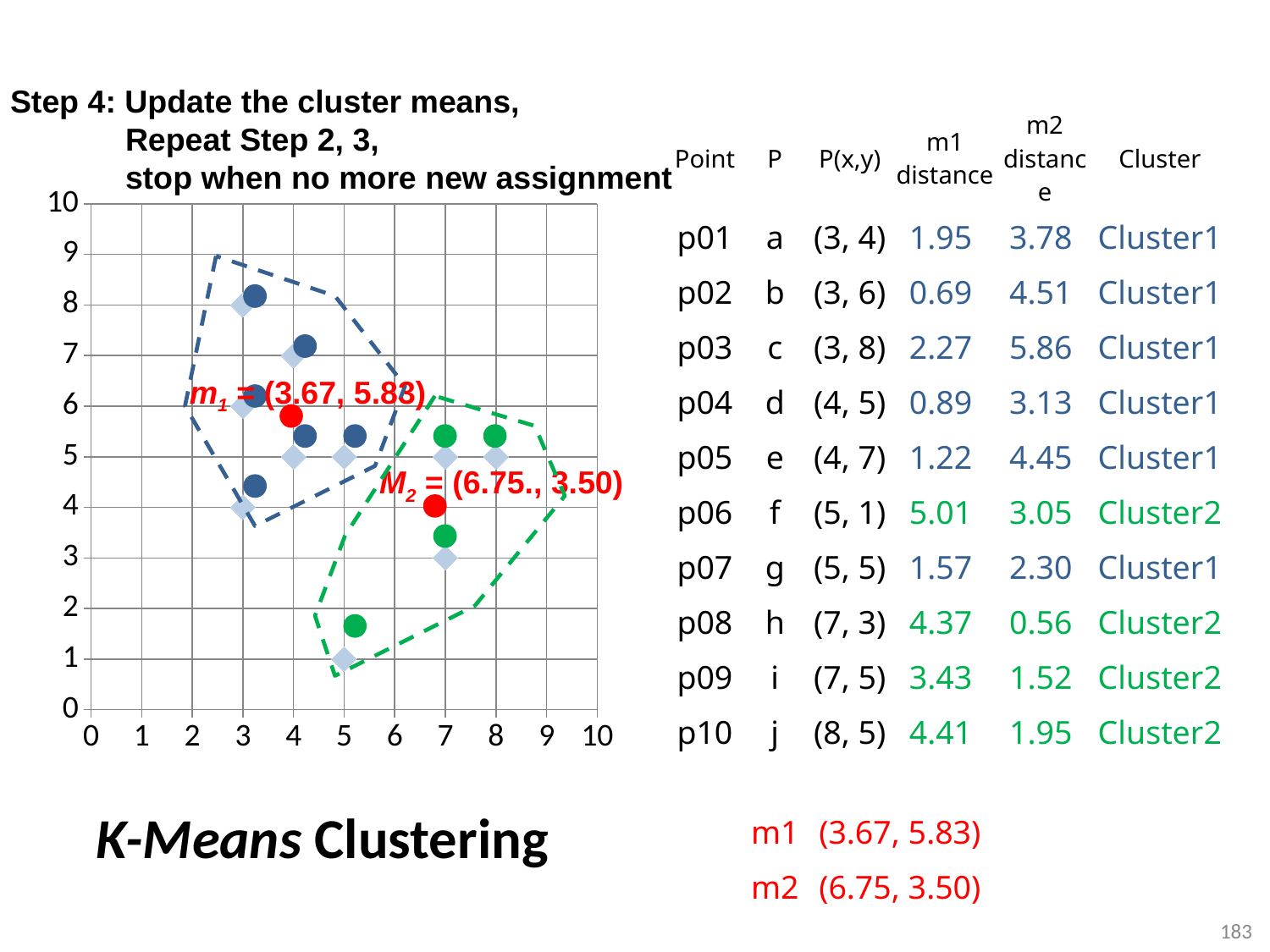
How many cluster means (red points) are plotted on the chart? 2 Which cluster mean has the larger x-coordinate, m1 or M2? M2 What is the maximum value shown on the x axis of the chart? 10 Which cluster mean has the larger y-coordinate, m1 or M2? m1 How many dashed cluster outlines are drawn on the chart? 2 What are the coordinates of the cluster mean M2 labelled on the chart? (6.75, 3.50) Is the x-coordinate of the cluster mean m1 greater or less than 3? greater What is the difference between the x-coordinates of M2 and m1? 3.08 What kind of chart is shown on the slide? scatter chart How many data points (diamond markers) are plotted on the chart? 10 Is the y-coordinate of the cluster mean M2 greater or less than 4? less What are the coordinates of the cluster mean m1 labelled on the chart? (3.67, 5.83)